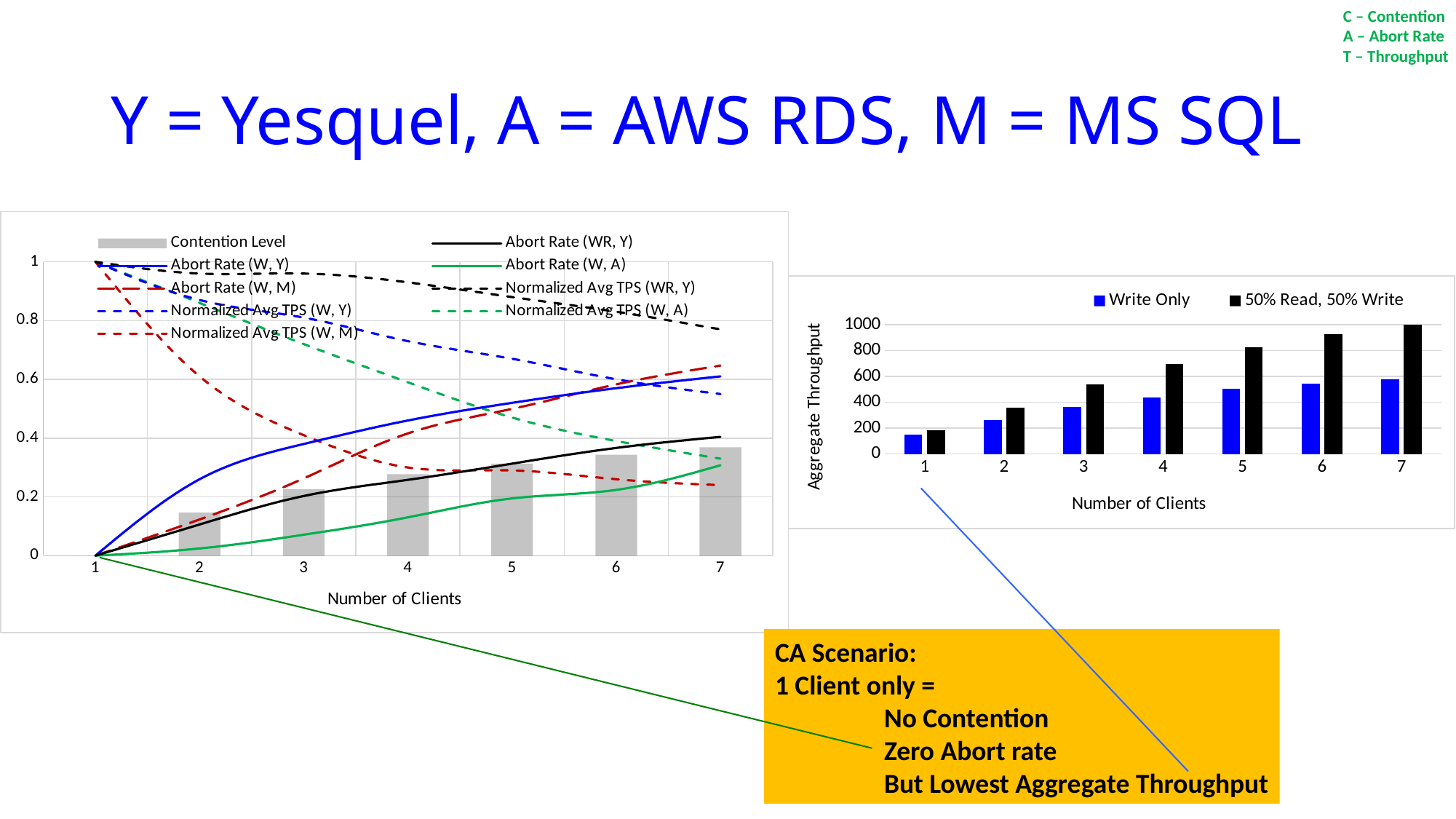
On the right chart, is the Write Only value for 1 client greater or less than 200? less On the right chart, is the 50% Read, 50% Write value for 7 clients greater or less than 800? greater On the left chart, is the Contention Level bar for 7 clients greater or less than 0.4? less On the right chart, at which number of clients is the 50% Read, 50% Write throughput highest? 7 On the left chart, does the Normalized Avg TPS (W, Y) line rise or fall as the number of clients increases? fall On the right chart, how many series does the legend list? 2 On the left chart, how many series does the legend list? 9 On the right chart, what kind of chart is it? bar chart On the right chart, at which number of clients is the Write Only throughput lowest? 1 On the right chart, how many client counts are shown on the x axis? 7 On the right chart, does the Write Only throughput rise or fall as the number of clients increases? rise On the right chart, for 4 clients, which series has the larger value: Write Only or 50% Read, 50% Write? 50% Read, 50% Write